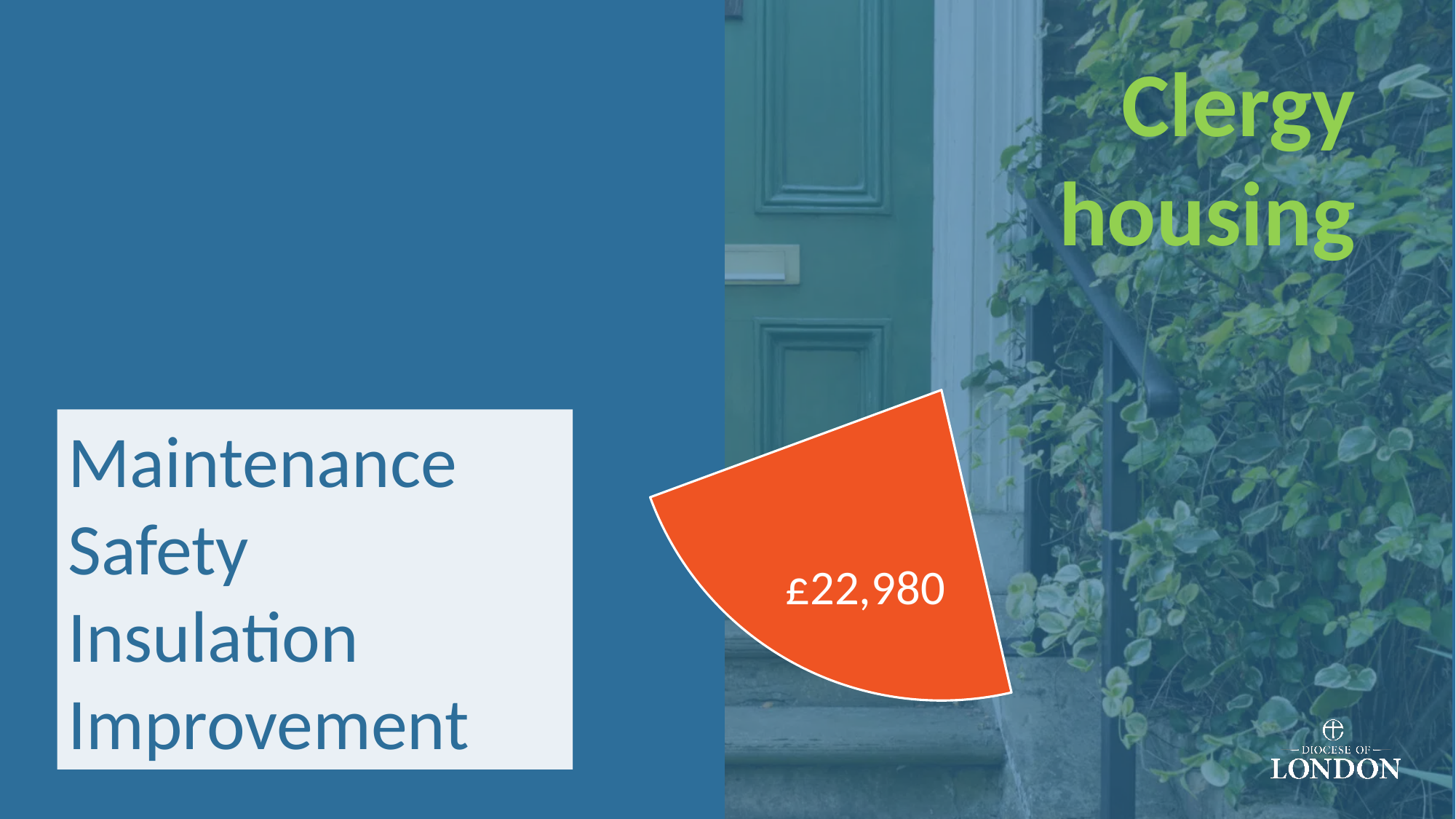
How many slices of the chart are visible on the slide? 1 What is the value shown for Clergy housing on the chart? £22,980 What kind of chart is the orange shape on the slide a part of? pie chart What heading is shown in green above the chart slice? Clergy housing What colour is the chart slice labelled £22,980? orange What value is printed on the orange slice of the chart? £22,980